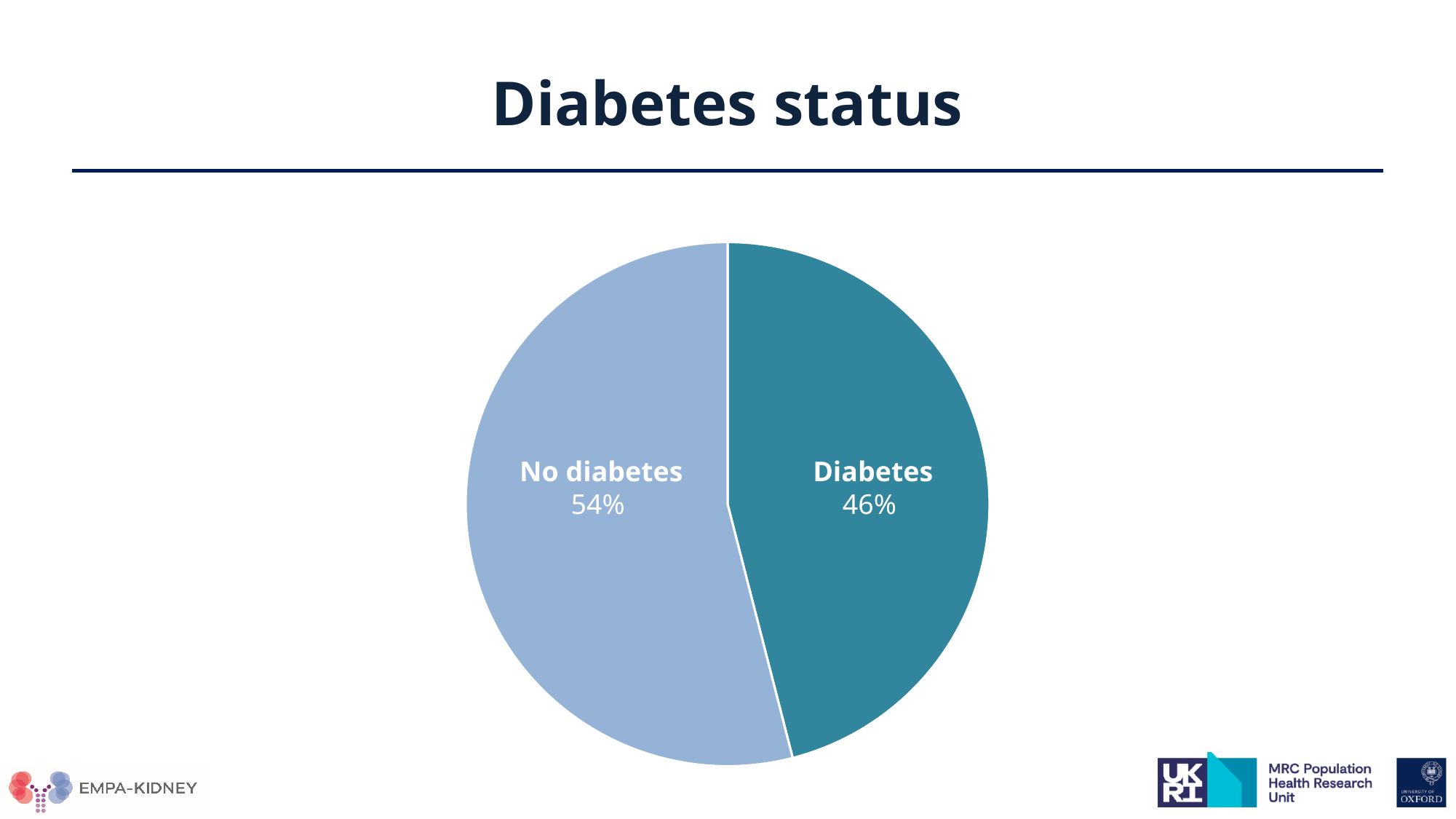
What is the difference in percentage points between the "No diabetes" and "Diabetes" slices? 8 Which slice is shown in the darker teal colour? Diabetes What share of the pie does the "Diabetes" slice represent? 46% What kind of chart is shown on the slide? Pie chart Which slice of the pie is the smallest? Diabetes Which is larger, the "Diabetes" slice or the "No diabetes" slice? No diabetes Which slice of the pie is the largest? No diabetes What percentage of the pie is labelled "No diabetes"? 54% What percentage of the pie is labelled "Diabetes"? 46% What is the title of the chart? Diabetes status How many slices does the pie chart have? 2